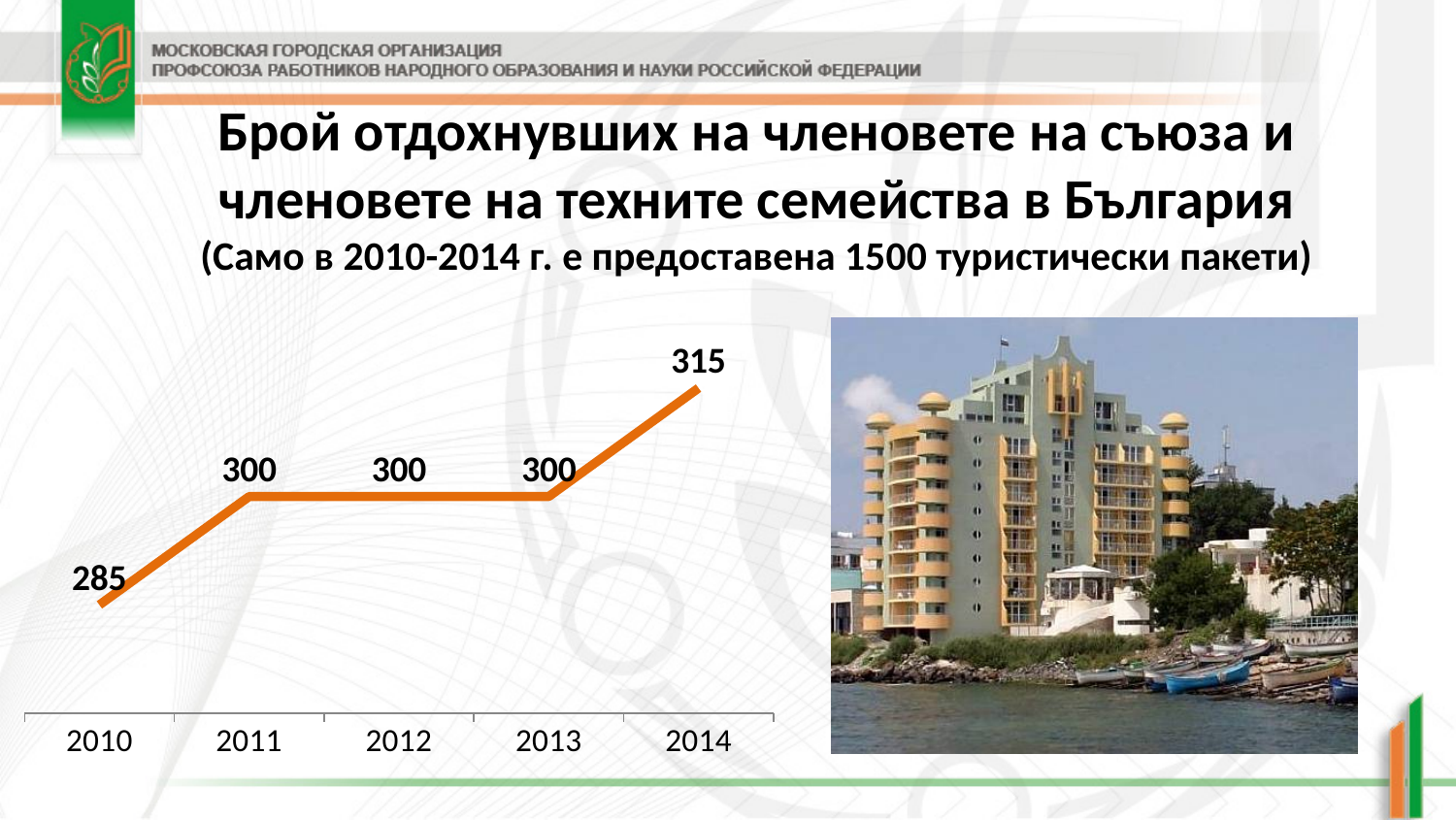
Do the values rise or fall from 2010 to 2014? rise How many years are plotted on the chart? 5 What was the value for 2014? 315 Which year has the highest value? 2014 Which is larger, the value for 2013 or the value for 2014? 2014 Which year has the lowest value? 2010 What kind of chart is shown on the slide? line chart What was the value for 2010? 285 What colour is the line on the chart? orange What is the difference between the values for 2011 and 2010? 15 What is the difference between the values for 2014 and 2010? 30 What was the value for 2012? 300